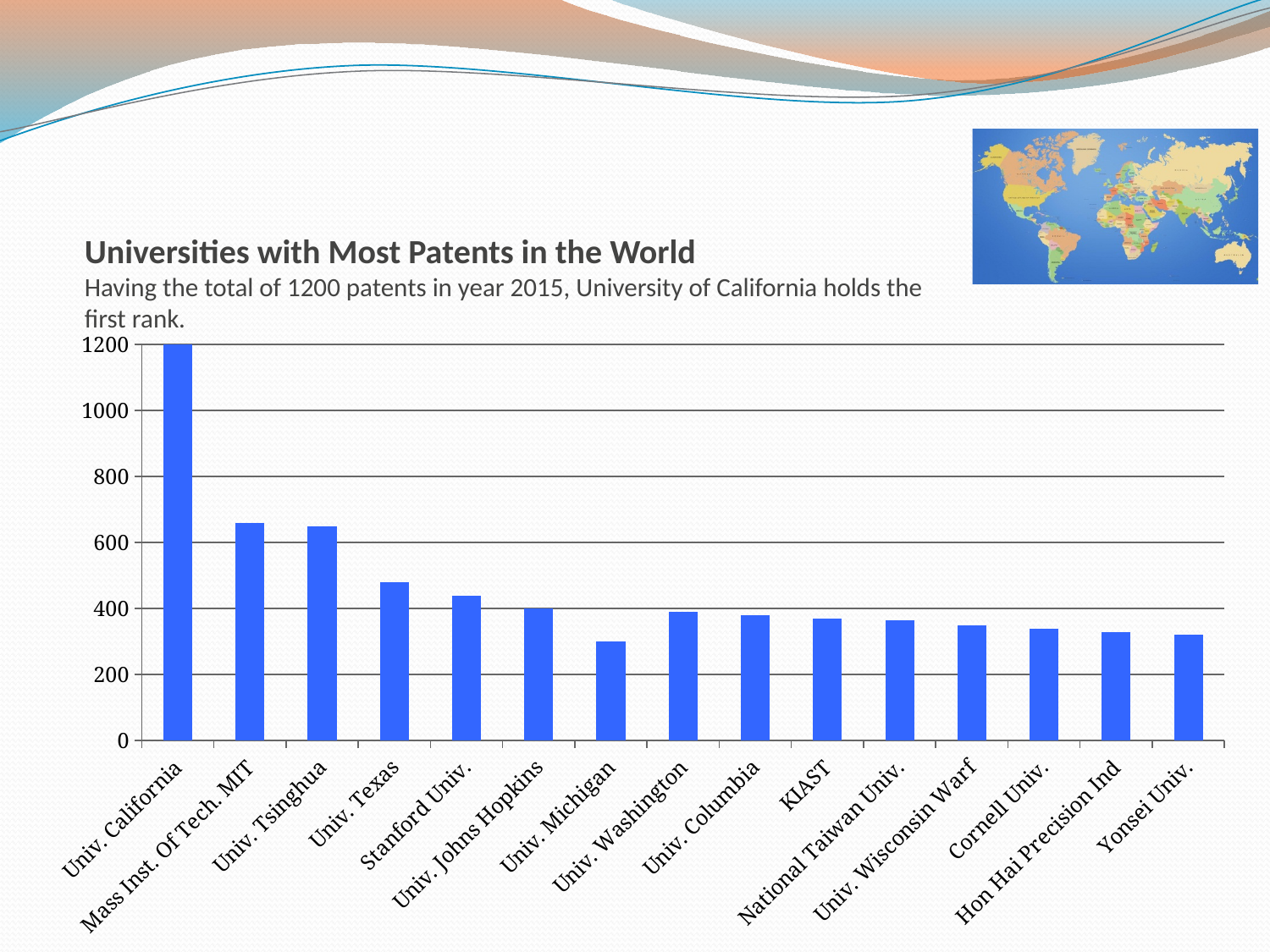
Do the values generally rise or fall from left to right along the x axis? fall What is the title of the chart on the slide? Universities with Most Patents in the World Is the value for Mass Inst. Of Tech. MIT greater or less than 600? greater Which has a larger value, Univ. Texas or Stanford Univ.? Univ. Texas Is the value for Cornell Univ. greater or less than 400? less Is the value for Univ. Michigan greater or less than 400? less How many universities are shown on the x axis of the chart? 15 What is the value for Univ. California in the chart? 1200 What type of chart is shown on the slide? Bar chart Which has a larger value, Univ. Michigan or Univ. Washington? Univ. Washington Which university has the highest number of patents in the chart? Univ. California